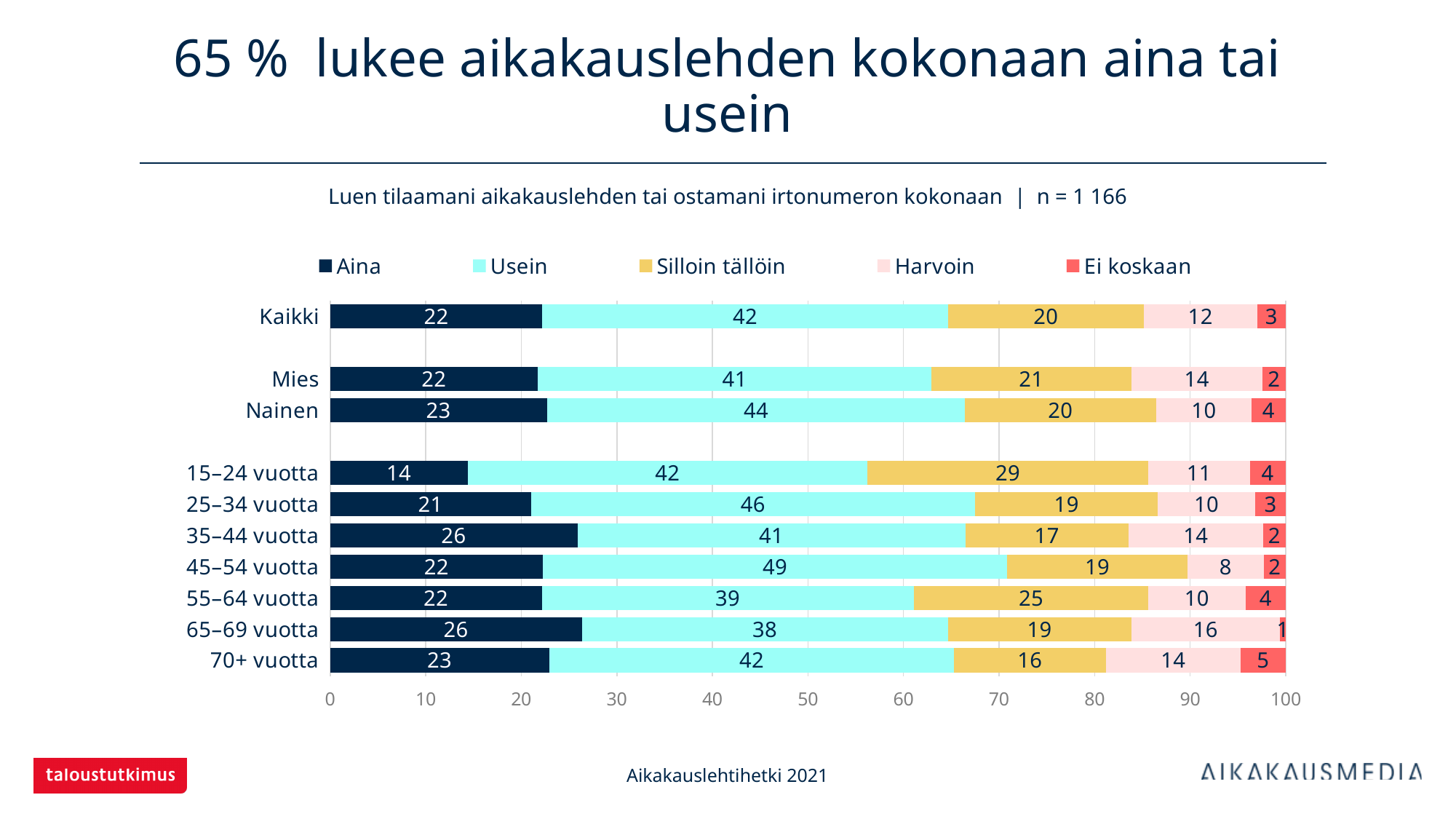
What kind of chart is shown on the slide? Stacked bar chart What sample size (n) is stated above the chart? 1 166 How many categories are shown on the y axis of the chart? 10 What is the value of the Usein series for 45–54 vuotta? 49 What is the value of the Aina series for 15–24 vuotta? 14 How many series does the legend list? 5 Which category has the highest value in the Silloin tällöin series? 15–24 vuotta Which category has the lowest value in the Ei koskaan series? 65–69 vuotta What is the total of the labelled segments in the Kaikki bar? 99 What is the value of the Ei koskaan series for 70+ vuotta? 5 What is the difference between the Usein values for Nainen and Mies? 3 Which has the larger Harvoin value, 65–69 vuotta or 70+ vuotta? 65–69 vuotta